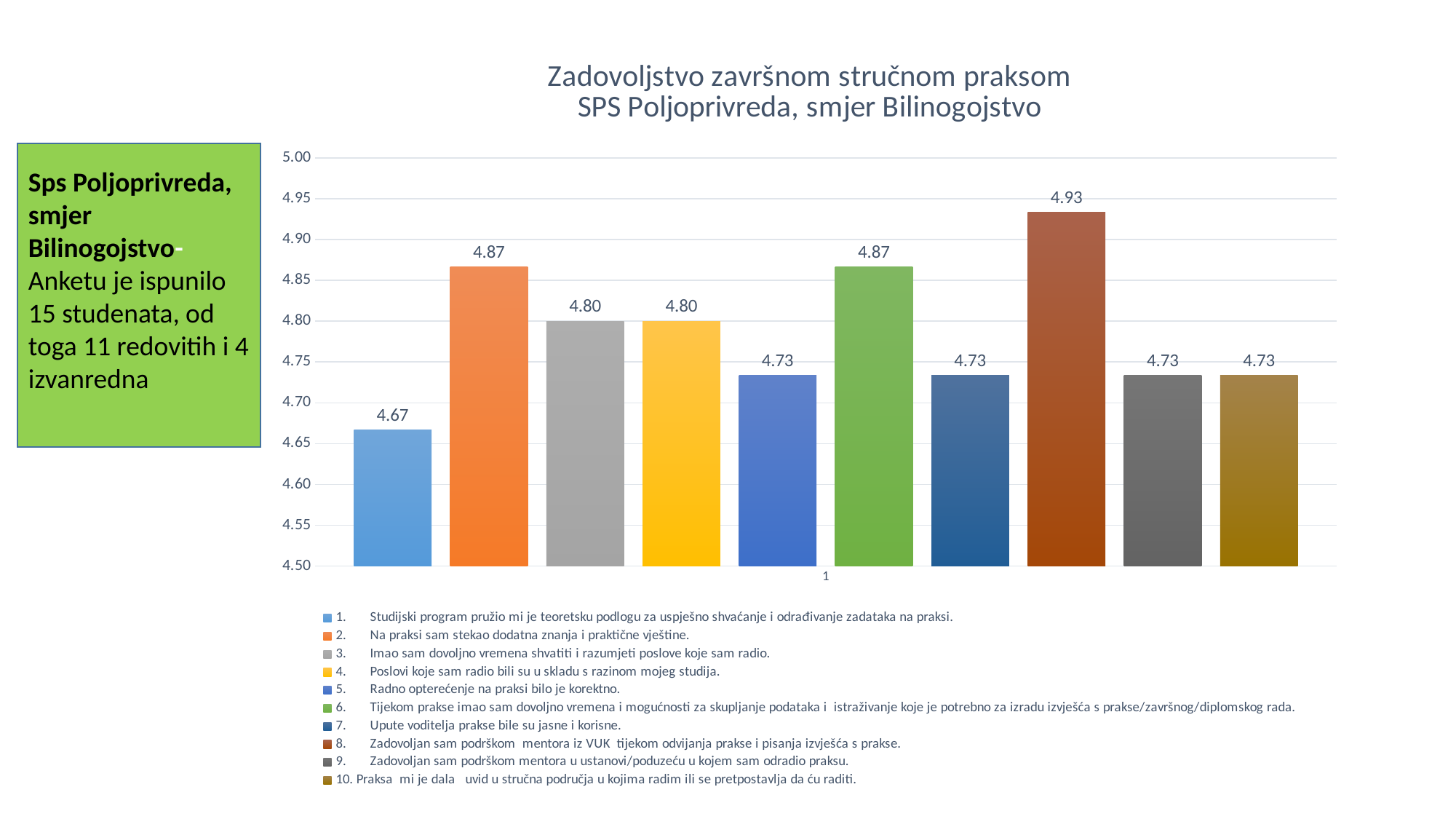
Which is larger, the value for series 6 or the value for series 7? Series 6 What is the difference between the value for series 2 and the value for series 3? 0.07 What is the difference between the value for series 8 and the value for series 1? 0.26 What is the value for series 2 ("Na praksi sam stekao dodatna znanja i praktične vještine.")? 4.87 What is the value for series 8 ("Zadovoljan sam podrškom mentora iz VUK...")? 4.93 Which series has the highest value? 8. Zadovoljan sam podrškom mentora iz VUK tijekom odvijanja prakse i pisanja izvješća s prakse. How many series does the legend list? 10 What is the title of the chart? Zadovoljstvo završnom stručnom praksom SPS Poljoprivreda, smjer Bilinogojstvo Which series has the lowest value? 1. Studijski program pružio mi je teoretsku podlogu za uspješno shvaćanje i odrađivanje zadataka na praksi. What is the value for series 5 ("Radno opterećenje na praksi bilo je korektno.")? 4.73 What is the value for series 1 ("Studijski program pružio mi je teoretsku podlogu...")? 4.67 What kind of chart is shown on the slide? Bar chart